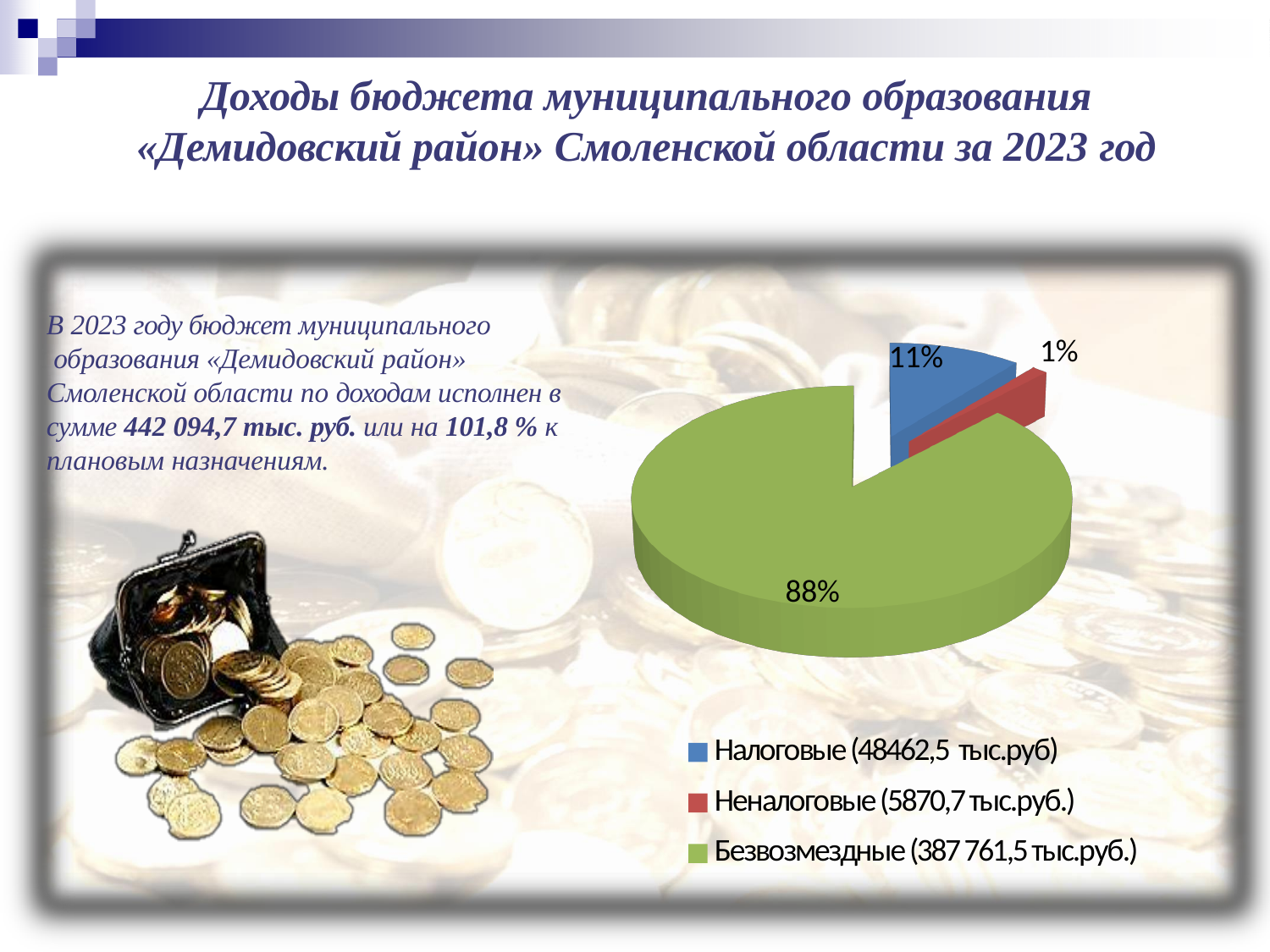
What kind of chart is shown on the slide? pie chart Which category has the largest slice in the pie chart? Безвозмездные What colour is the Безвозмездные slice in the pie chart? green What share of the pie does the Налоговые slice represent? 11% What share of the pie does the Неналоговые slice represent? 1% What share of the pie does the Безвозмездные slice represent? 88% How many slices does the pie chart have? 3 Which slice is larger, Налоговые or Неналоговые? Налоговые How many entries does the legend of the pie chart list? 3 What amount in тыс.руб. is given in the legend for Налоговые? 48462,5 Which category has the smallest slice in the pie chart? Неналоговые What is the difference in percentage points between the Безвозмездные and Налоговые slices? 77